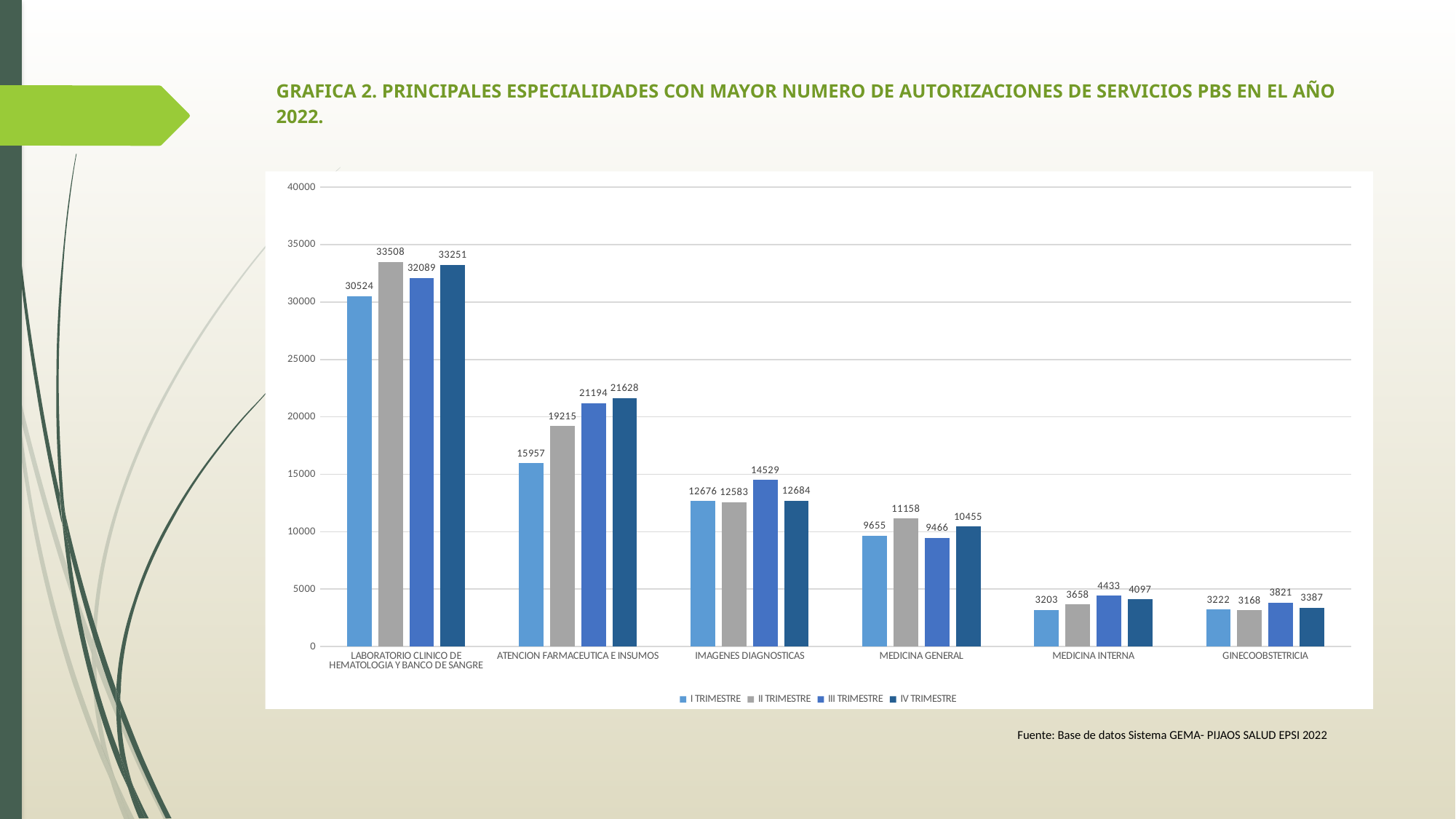
What is the value for I TRIMESTRE in the ATENCION FARMACEUTICA E INSUMOS category? 15957 How many categories are shown on the x axis? 6 What is the difference between the IV TRIMESTRE and I TRIMESTRE values for ATENCION FARMACEUTICA E INSUMOS? 5671 What is the value for III TRIMESTRE in the IMAGENES DIAGNOSTICAS category? 14529 Which category has the lowest value for II TRIMESTRE? GINECOOBSTETRICIA Which series is shown in grey in the legend? II TRIMESTRE Which is larger for MEDICINA INTERNA: the III TRIMESTRE value or the IV TRIMESTRE value? III TRIMESTRE What is the value for II TRIMESTRE in the LABORATORIO CLINICO DE HEMATOLOGIA Y BANCO DE SANGRE category? 33508 What kind of chart is shown on the slide? Bar chart Which category has the highest value for IV TRIMESTRE? LABORATORIO CLINICO DE HEMATOLOGIA Y BANCO DE SANGRE What is the value for IV TRIMESTRE in the MEDICINA GENERAL category? 10455 How many series does the legend list? 4